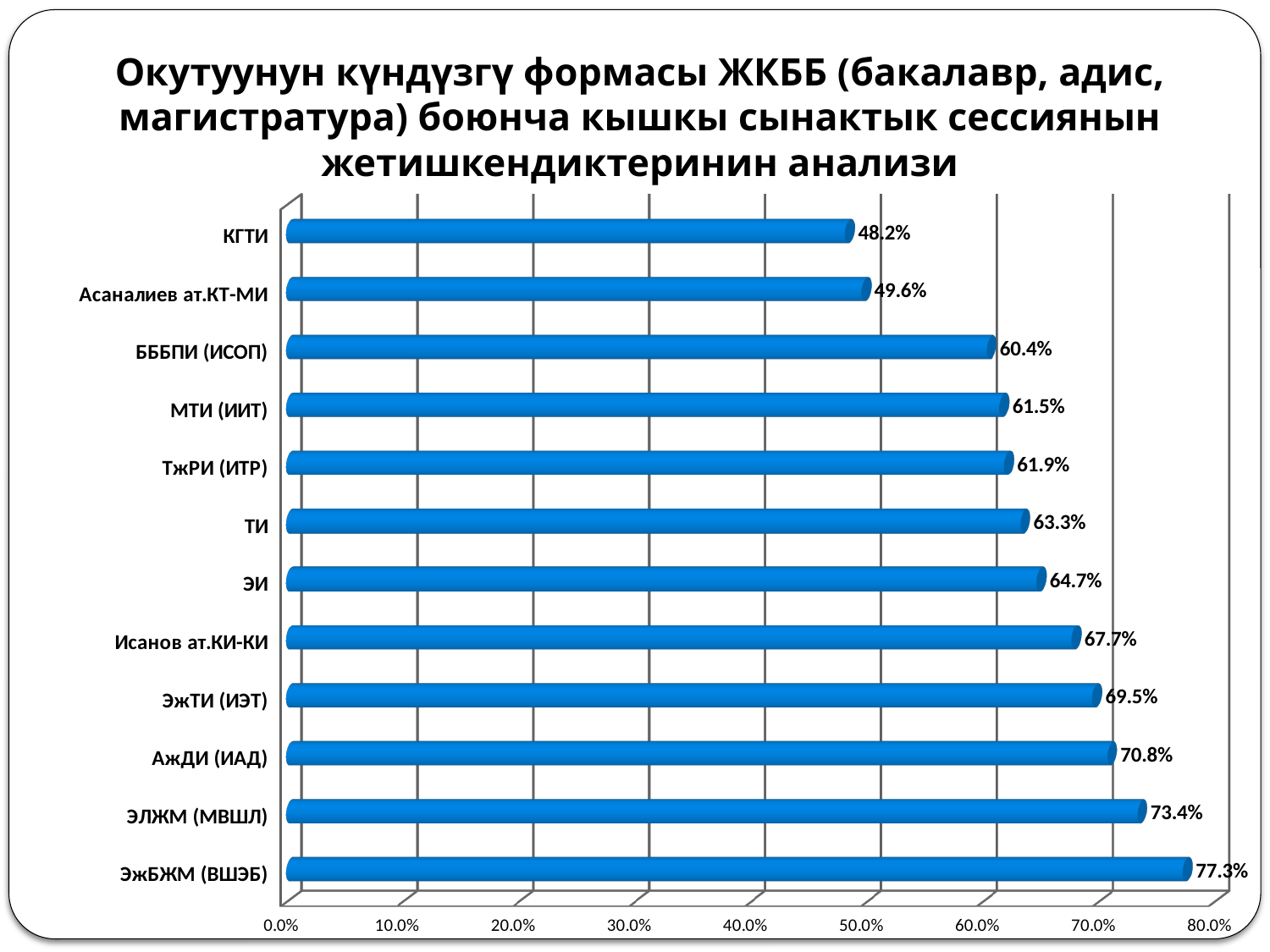
What kind of chart is shown on the slide? bar chart Which category has the highest value? ЭжБЖМ (ВШЭБ) What is the difference between the values for ЭжБЖМ (ВШЭБ) and КГТИ? 29.1% How many categories are shown in the chart? 12 What is the value for КГТИ? 48.2% Which category has the lowest value? КГТИ What is the difference between the values for АжДИ (ИАД) and ЭИ? 6.1% What is the maximum value shown on the horizontal axis? 80.0% What is the value for ТИ? 63.3% What is the value for ЭжБЖМ (ВШЭБ)? 77.3% Which is larger, the value for ЭЛЖМ (МВШЛ) or the value for ЭжТИ (ИЭТ)? ЭЛЖМ (МВШЛ) Is the value for Асаналиев ат.КТ-МИ greater or less than 50.0%? less